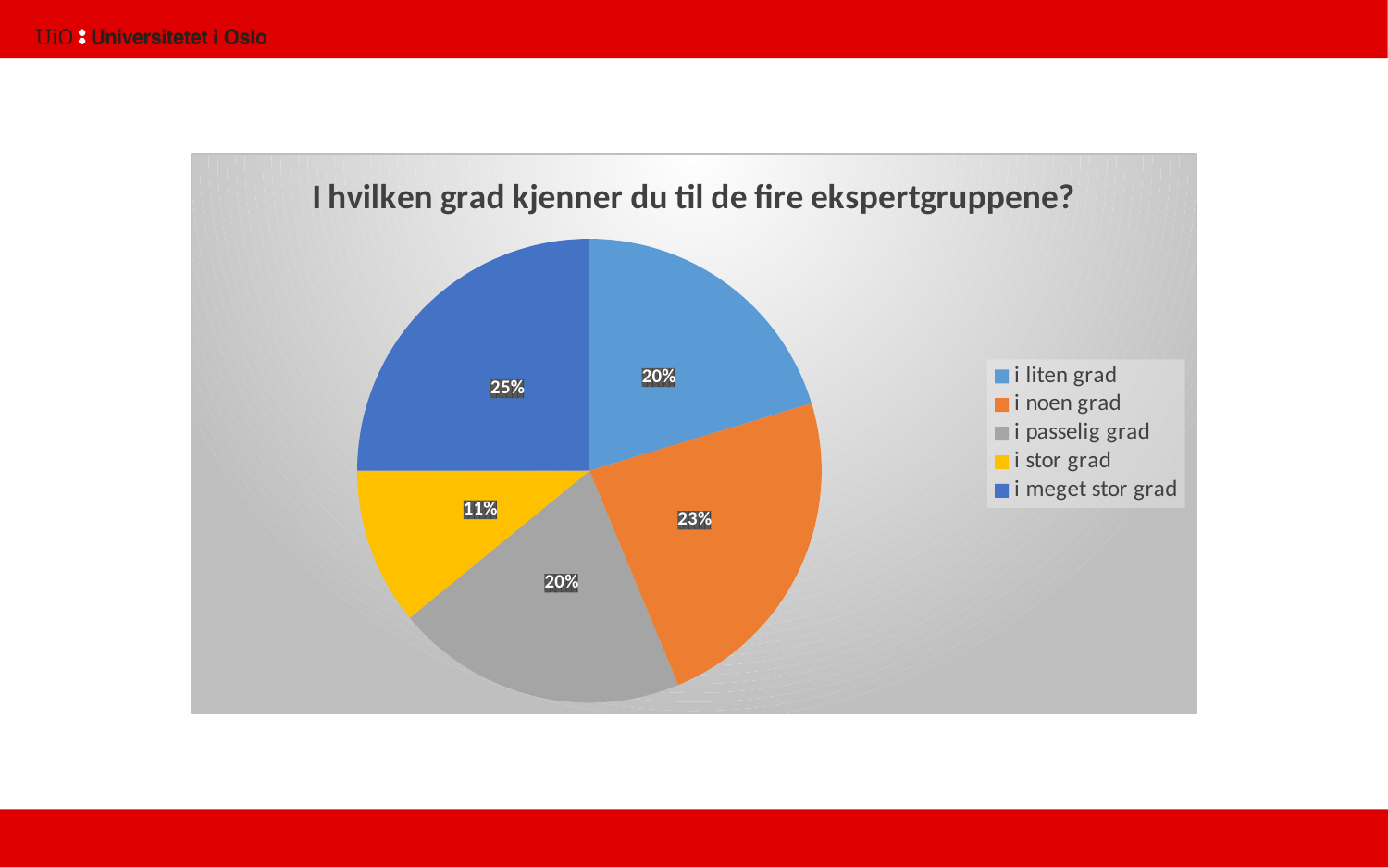
What share of the pie is 'i noen grad'? 23% What kind of chart is shown on the slide? pie chart Which is larger, the share for 'i noen grad' or the share for 'i passelig grad'? i noen grad What share of the pie is 'i liten grad'? 20% What is the title of the chart? I hvilken grad kjenner du til de fire ekspertgruppene? How many categories does the legend list? 5 What colour is the slice for 'i stor grad'? yellow What share of the pie is 'i stor grad'? 11% What is the difference between the shares for 'i meget stor grad' and 'i stor grad'? 14% Which category has the largest share of the pie? i meget stor grad Which category has the smallest share of the pie? i stor grad